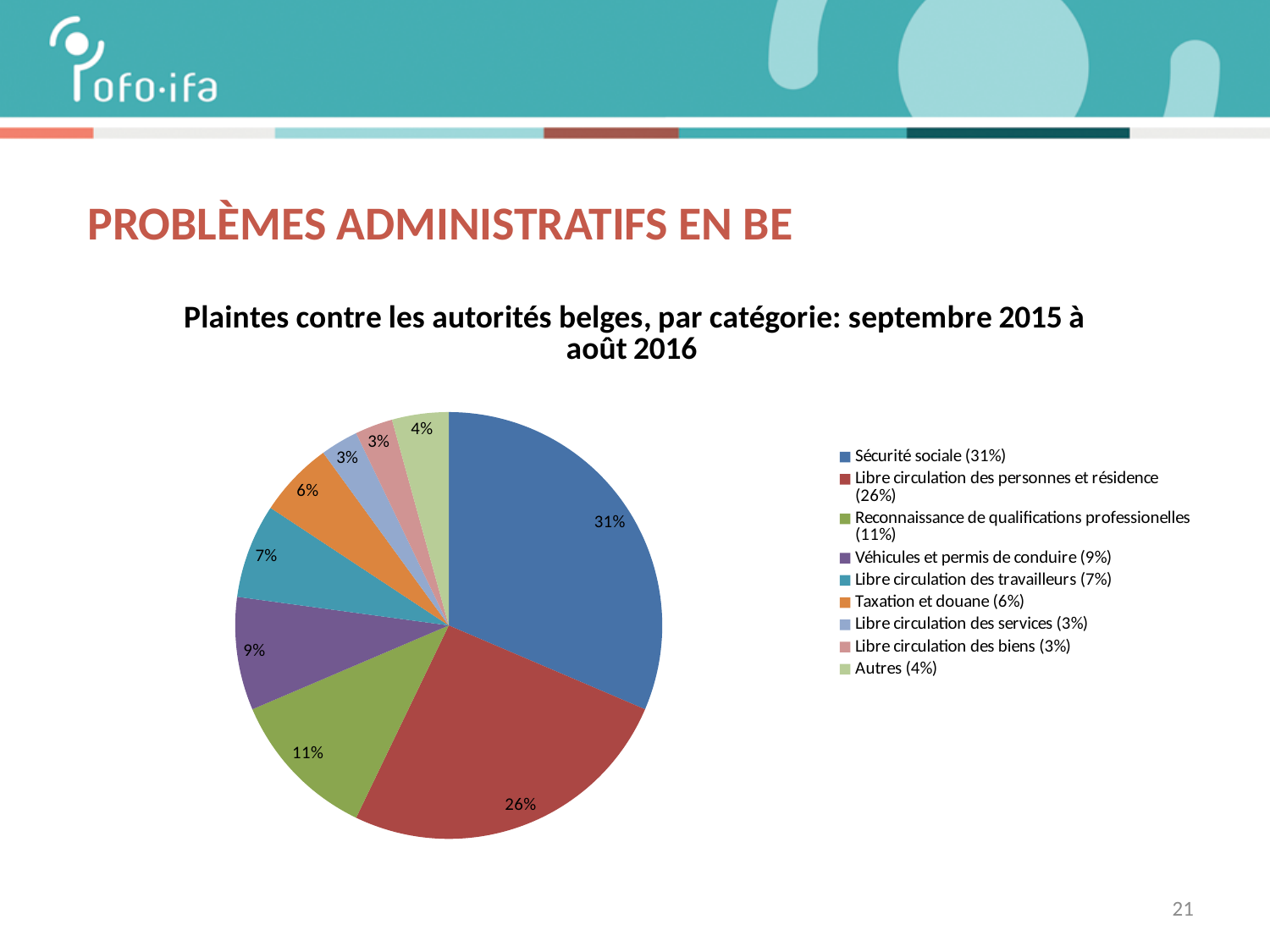
What share of the pie is Sécurité sociale? 31% Which category has the largest share? Sécurité sociale What is the value for Taxation et douane? 6% What is the value for Autres? 4% What is the value for Libre circulation des personnes et résidence? 26% What kind of chart is shown on the slide? pie chart How many categories does the legend list? 9 What is the difference between Reconnaissance de qualifications professionelles and Taxation et douane? 5% What is the value for Reconnaissance de qualifications professionelles? 11% Which is larger, Véhicules et permis de conduire or Libre circulation des travailleurs? Véhicules et permis de conduire What is the difference between the shares of Sécurité sociale and Libre circulation des personnes et résidence? 5% What is the title of the chart? Plaintes contre les autorités belges, par catégorie: septembre 2015 à août 2016